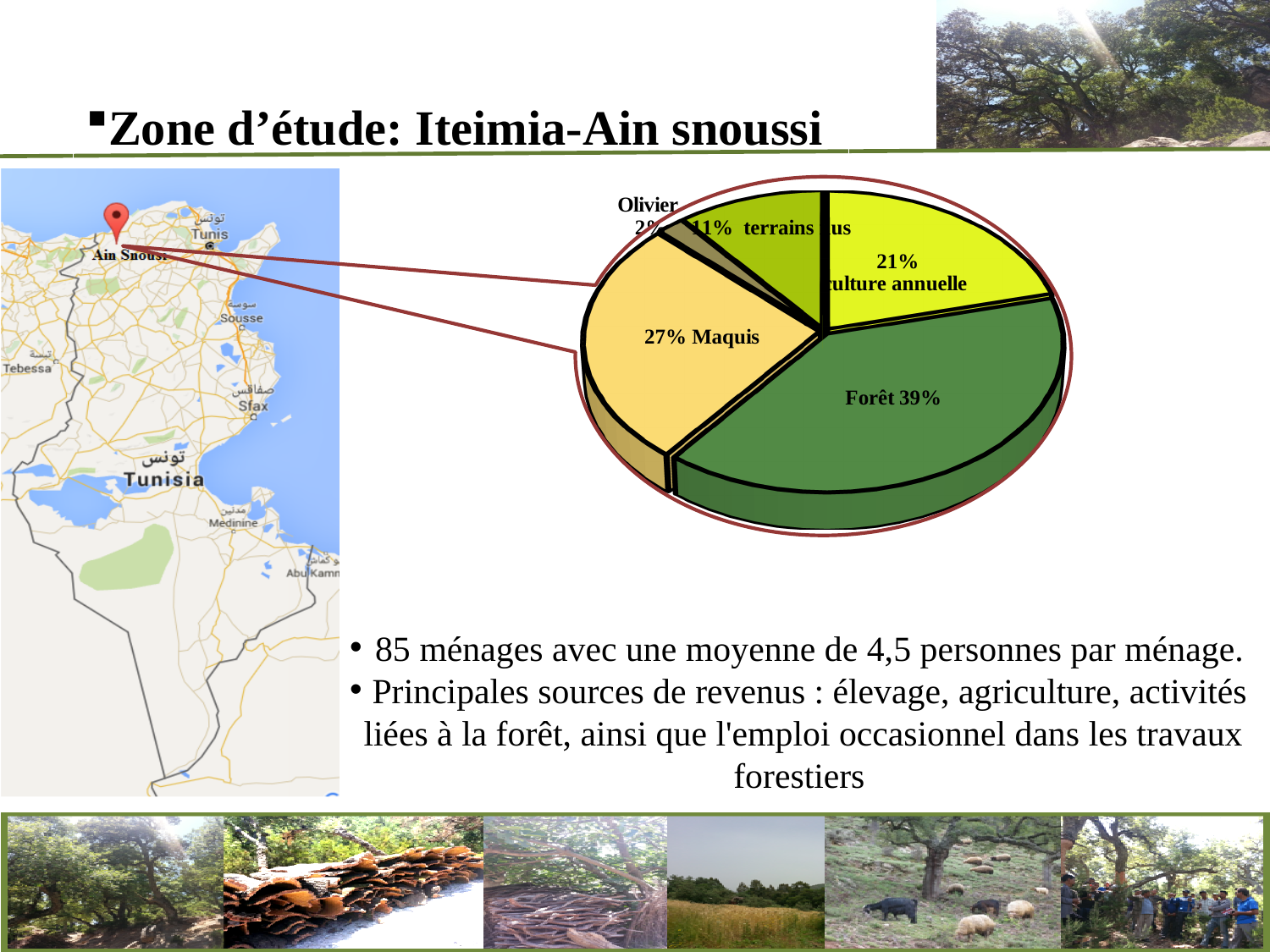
What percentage does the Maquis slice represent? 27% What percentage is shown for culture annuelle? 21% What percentage is shown for Olivier? 2% Which is larger, the Maquis slice or the culture annuelle slice? Maquis What colour is the Forêt slice of the pie chart? green Which category has the largest slice of the pie chart? Forêt What percentage is shown for terrains nus? 11% What is the difference in percentage points between Forêt and Maquis? 12% Which category has the smallest slice of the pie chart? Olivier What share of the pie chart is Forêt? 39% What kind of chart is shown on the slide? pie chart How many slices does the pie chart have? 5